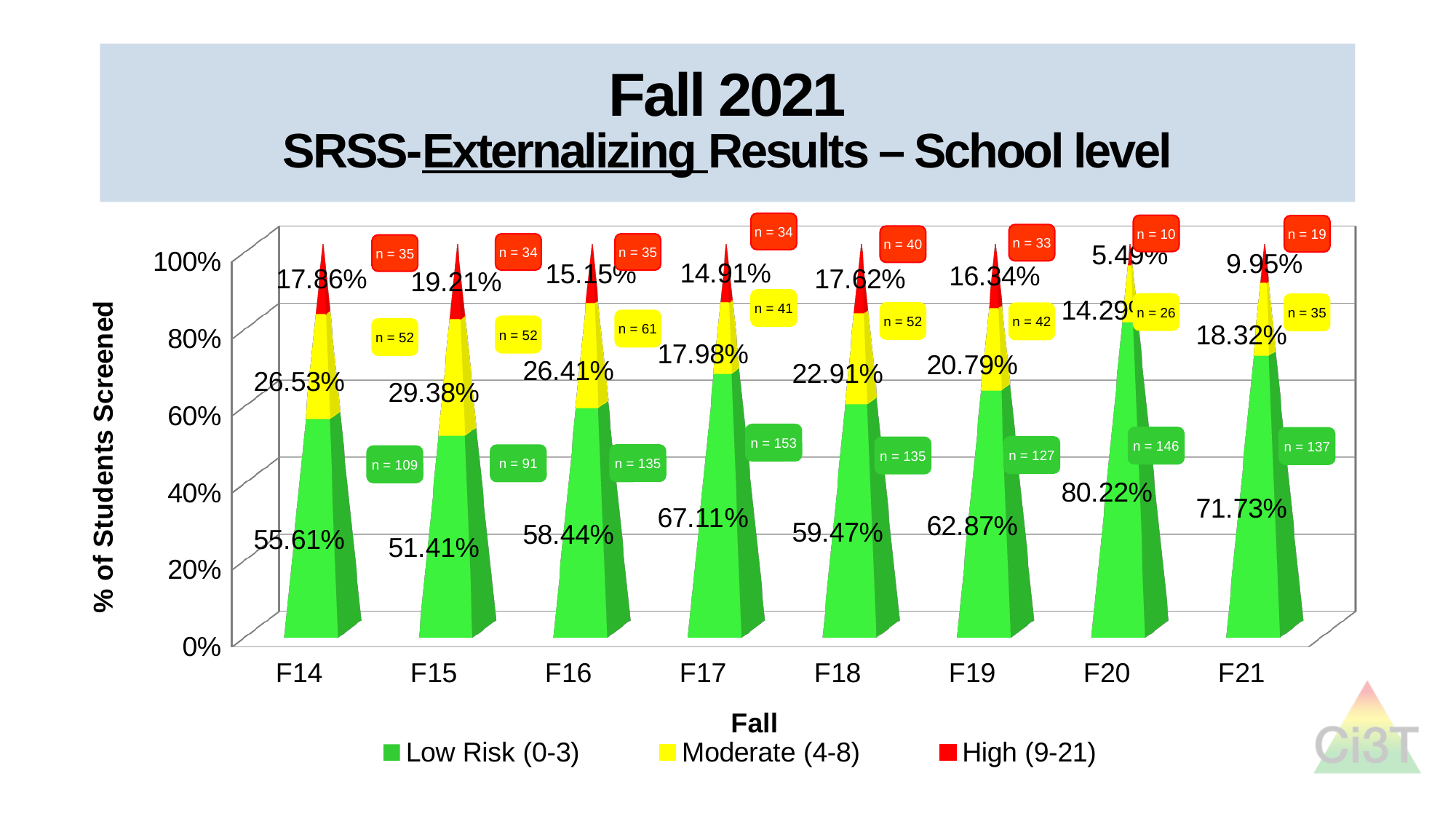
By how many percentage points does the Low Risk (0-3) share in F21 exceed that in F14? 16.12 percentage points How many series does the legend list? 3 Which has the larger Moderate (4-8) percentage, F16 or F19? F16 What kind of chart is shown on the slide? Stacked bar chart What is the Moderate (4-8) percentage for F15? 29.38% What is the Low Risk (0-3) percentage for F17? 67.11% Which colour represents the High (9-21) group in the legend? Red Which fall has the lowest Low Risk (0-3) percentage? F15 What is the n value shown for the Low Risk (0-3) group in F17? n = 153 Which fall has the highest Low Risk (0-3) percentage? F20 What is the High (9-21) percentage for F18? 17.62% How many fall screening periods are shown on the x axis? 8